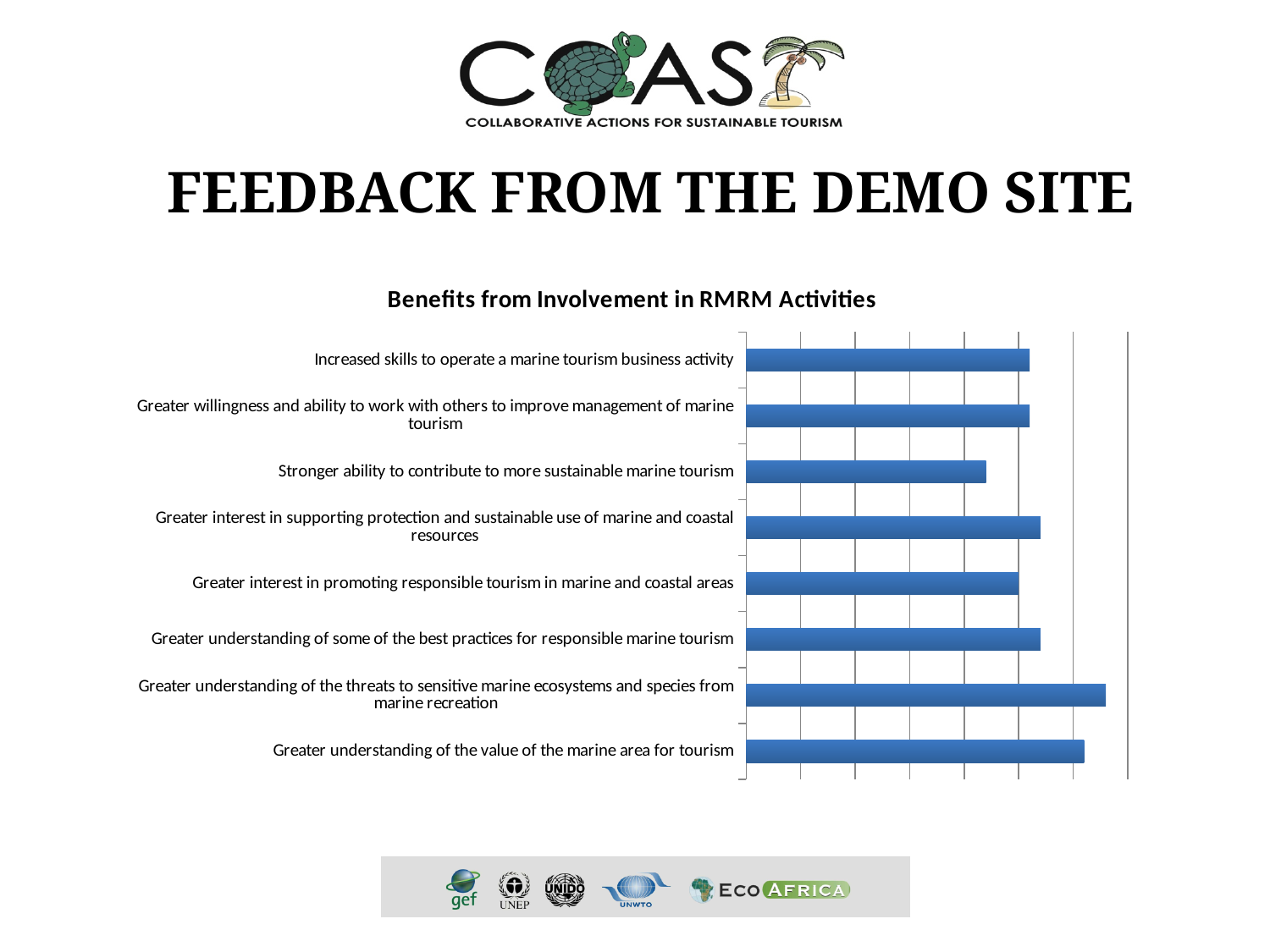
Which bar is longer: 'Greater understanding of the threats to sensitive marine ecosystems and species from marine recreation' or 'Greater understanding of some of the best practices for responsible marine tourism'? Greater understanding of the threats to sensitive marine ecosystems and species from marine recreation Which category has the longest bar in the chart? Greater understanding of the threats to sensitive marine ecosystems and species from marine recreation What is the title of the chart? Benefits from Involvement in RMRM Activities How many categories (bars) does the chart show? 8 Which bar is longer: 'Stronger ability to contribute to more sustainable marine tourism' or 'Greater interest in promoting responsible tourism in marine and coastal areas'? Greater interest in promoting responsible tourism in marine and coastal areas Which bar is longer: 'Greater understanding of the value of the marine area for tourism' or 'Stronger ability to contribute to more sustainable marine tourism'? Greater understanding of the value of the marine area for tourism What colour are the bars in the chart? Blue What type of chart is shown on the slide? Bar chart Which category is listed at the top of the chart? Increased skills to operate a marine tourism business activity Which category has the shortest bar in the chart? Stronger ability to contribute to more sustainable marine tourism